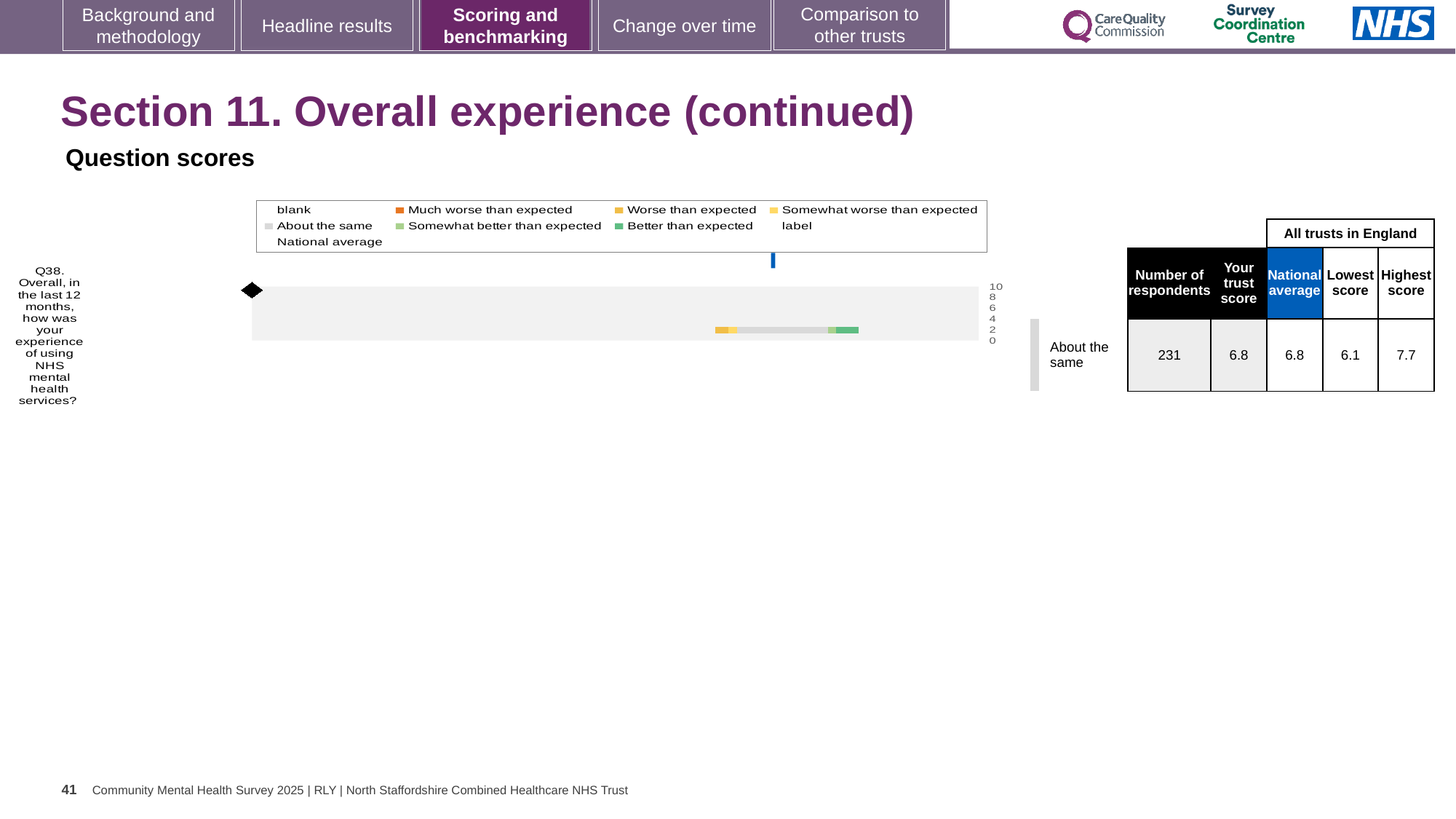
What is the highest score among all trusts in England for Q38? 7.7 What is the difference between the highest and lowest trust scores for Q38? 1.6 How many survey questions are plotted in the chart? 1 What is the national average score for Q38? 6.8 What is the lowest score among all trusts in England for Q38? 6.1 Is the trust's score for Q38 higher than, lower than, or the same as the national average? the same What is the number of respondents for Q38? 231 What is the trust's score for Q38? 6.8 Which legend entry is shown in dark green? Better than expected Which benchmarking category is the trust's Q38 score placed in? About the same What is the highest value shown on the chart's axis? 10 What kind of chart is shown for Q38 on the slide? bar chart